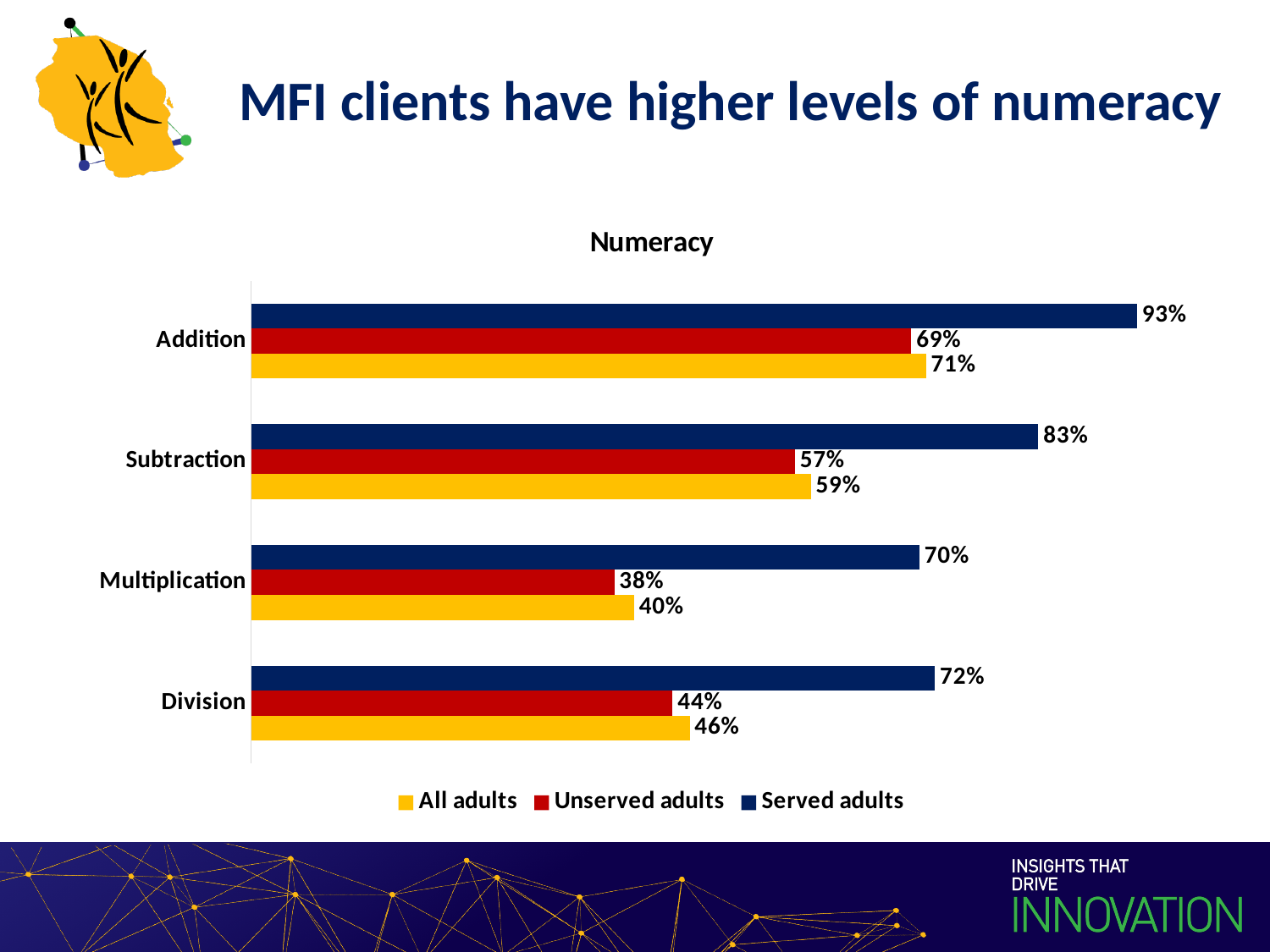
What is the value for All adults in the Division category? 46% What is the title of the chart? Numeracy Which category has the lowest value for Unserved adults? Multiplication What is the value for Unserved adults in the Multiplication category? 38% What kind of chart is shown on the slide? Bar chart Which colour represents Served adults in the chart? Dark blue How many categories are shown on the chart? 4 What is the value for Served adults in the Addition category? 93% Which category has the highest value for Served adults? Addition How many series does the legend list? 3 What is the difference between Served adults and Unserved adults in the Subtraction category? 26% Which is larger: the All adults value for Subtraction or the All adults value for Division? Subtraction